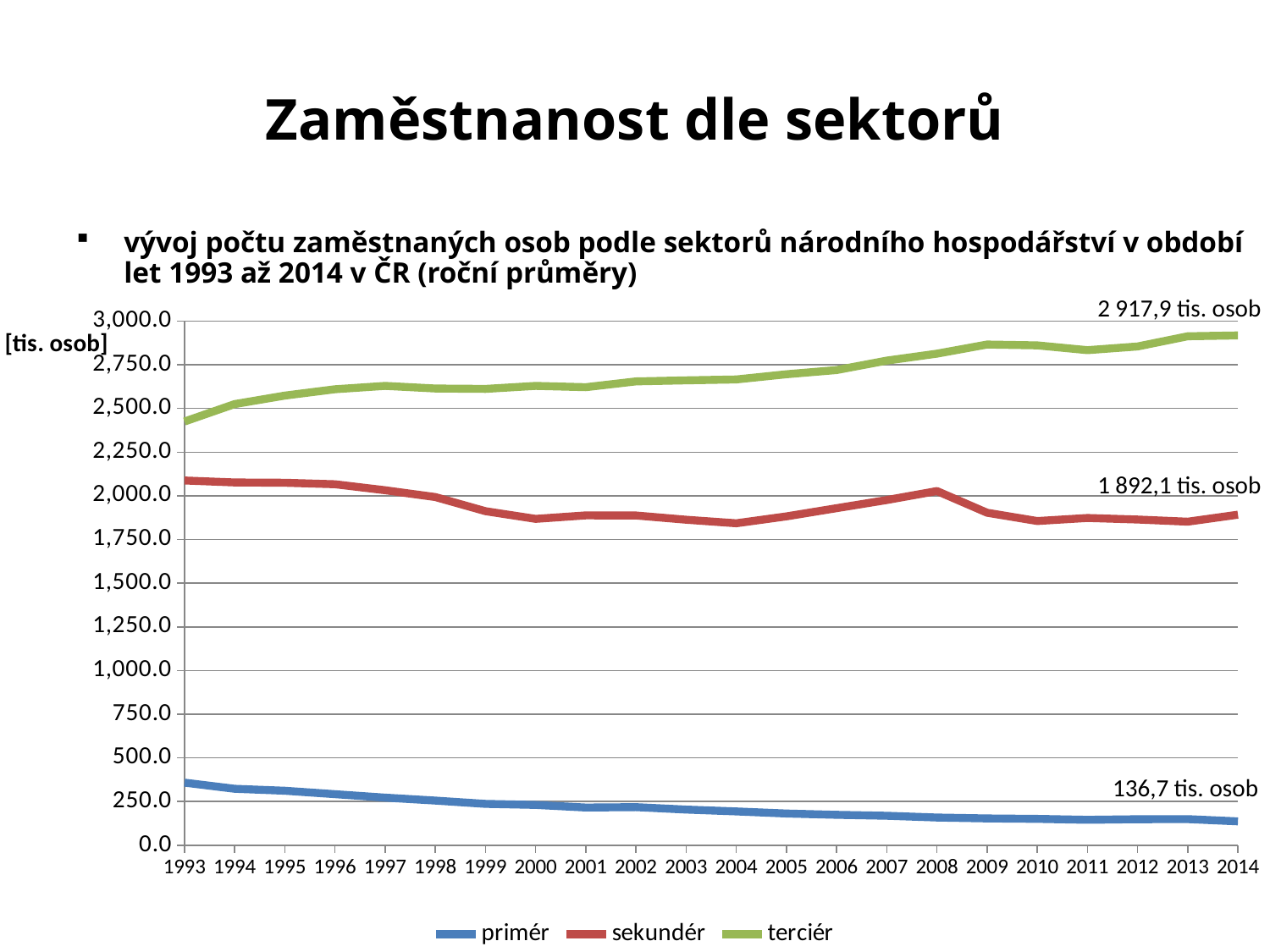
Does the terciér series rise or fall from 1993 to 2014? rise How many years are shown on the x axis? 22 What are the series names listed in the legend? primér, sekundér, terciér Does the primér series rise or fall from 1993 to 2014? fall Is the value for sekundér in 1993 greater or less than 2,000.0? greater What is the value for sekundér in 2014? 1 892,1 tis. osob Which series has the highest value in 2014? terciér What is the value for primér in 2014? 136,7 tis. osob Which series has the lowest value in 2014? primér What kind of chart is shown on the slide? line chart How many series does the legend list? 3 What is the value for terciér in 2014? 2 917,9 tis. osob